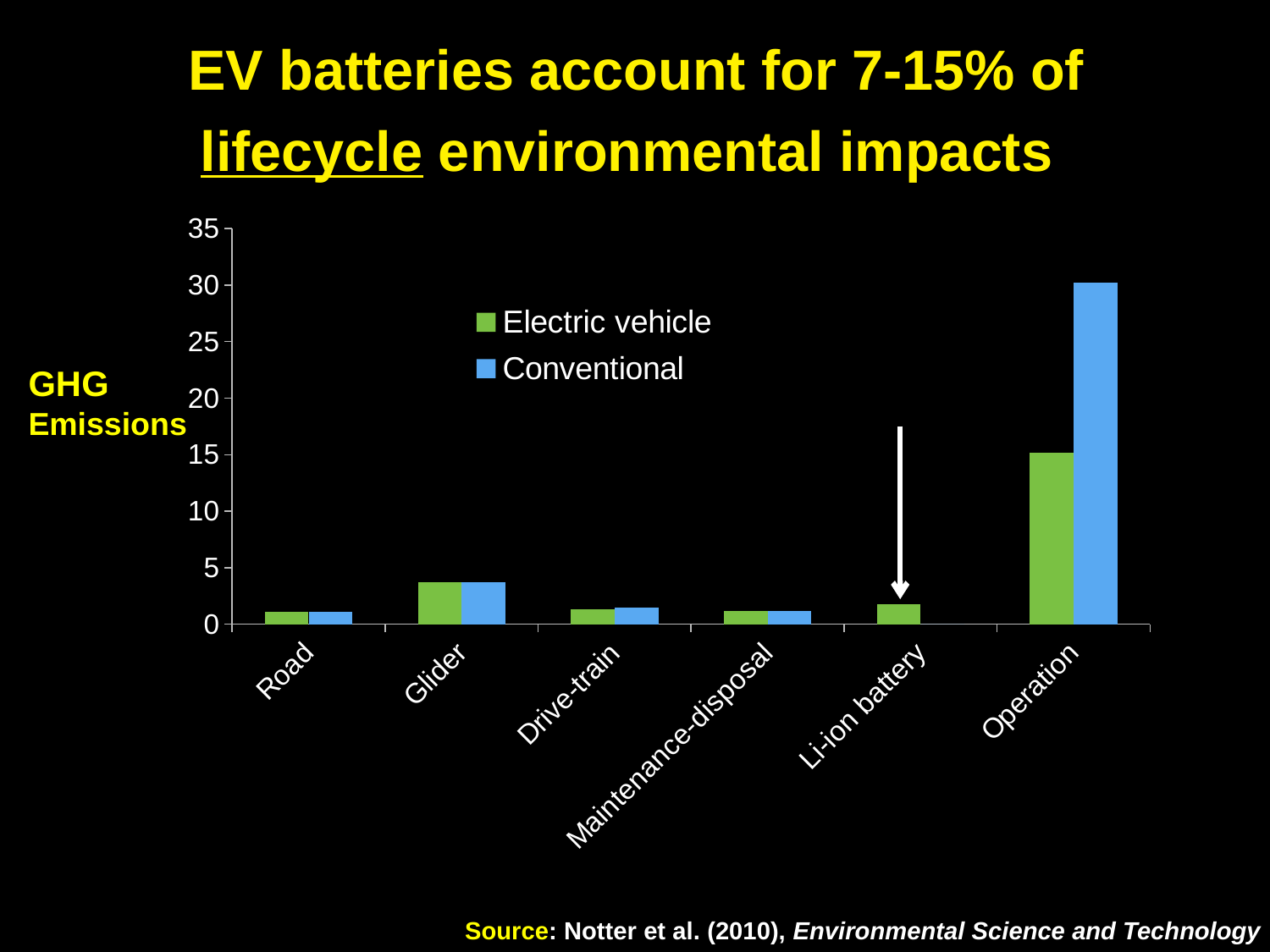
Which series is shown in green in the legend? Electric vehicle Is the Conventional value for Operation greater or less than 25? greater Is the Electric vehicle value for Glider greater or less than 5? less What is the label on the vertical axis of the chart? GHG Emissions For Operation, which series has the larger value, Electric vehicle or Conventional? Conventional Which category has the highest GHG emissions for the Electric vehicle series? Operation How many series does the legend list? 2 Is the Electric vehicle value for Operation greater or less than 10? greater What kind of chart is shown on the slide? bar chart How many categories are shown on the x axis? 6 Which category has the highest GHG emissions for the Conventional series? Operation